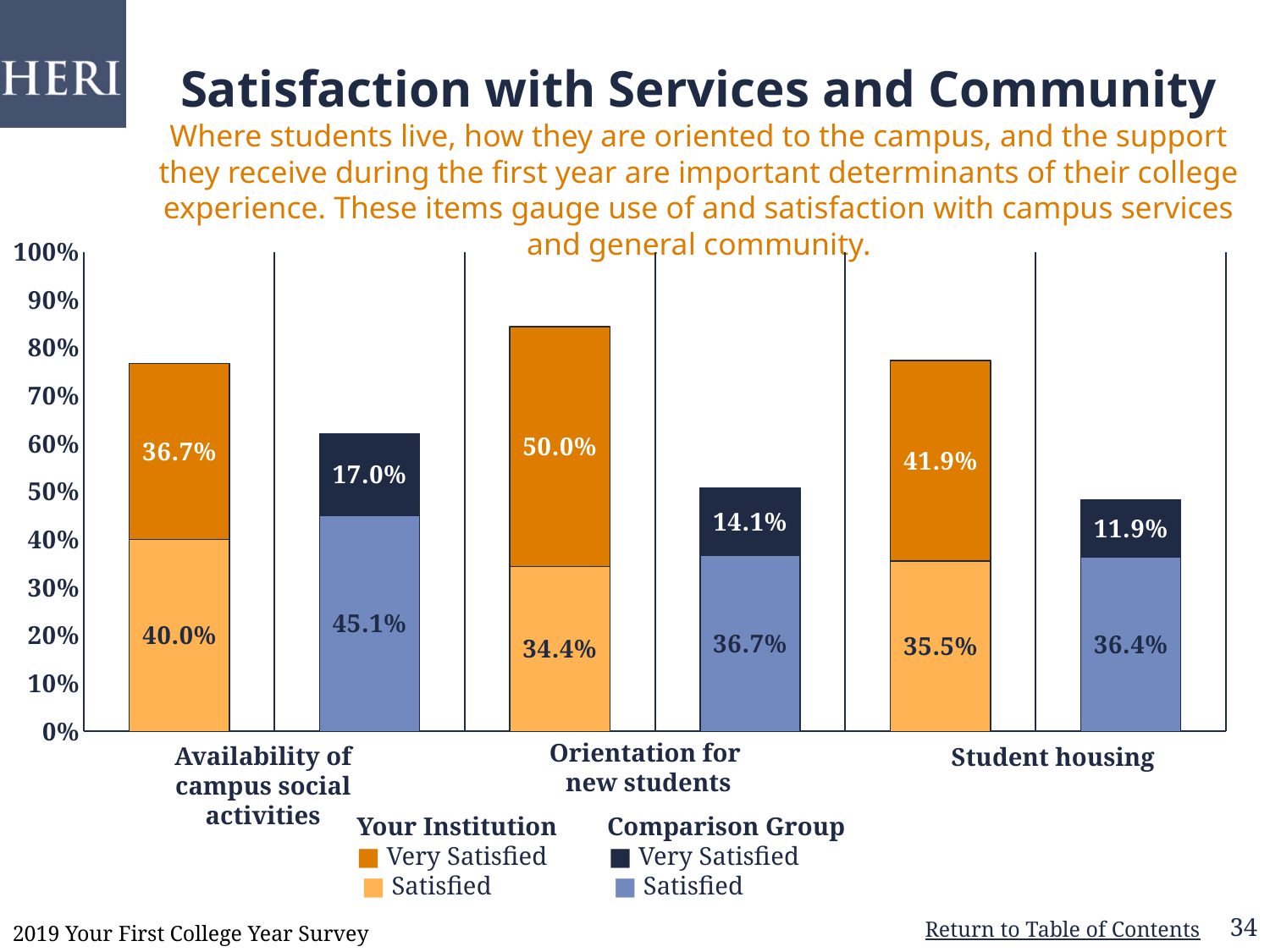
What is the difference between the Your Institution and Comparison Group Very Satisfied percentages for Availability of campus social activities? 19.7% What kind of chart is shown on the slide? Stacked bar chart What is the total (Satisfied plus Very Satisfied) for the Comparison Group bar for Student housing? 48.3% Which category has the highest Very Satisfied percentage for Your Institution? Orientation for new students What percentage of Your Institution students were Very Satisfied with Orientation for new students? 50.0% Which is larger: the Satisfied percentage for Your Institution or for the Comparison Group in Student housing? Comparison Group Which category has the lowest Very Satisfied percentage for the Comparison Group? Student housing What percentage of Comparison Group students were Very Satisfied with Student housing? 11.9% What percentage of Comparison Group students were Satisfied with Availability of campus social activities? 45.1% How many entries does the chart legend list? 4 How many categories are shown on the x axis of the chart? 3 What is the total (Satisfied plus Very Satisfied) for the Your Institution bar for Orientation for new students? 84.4%